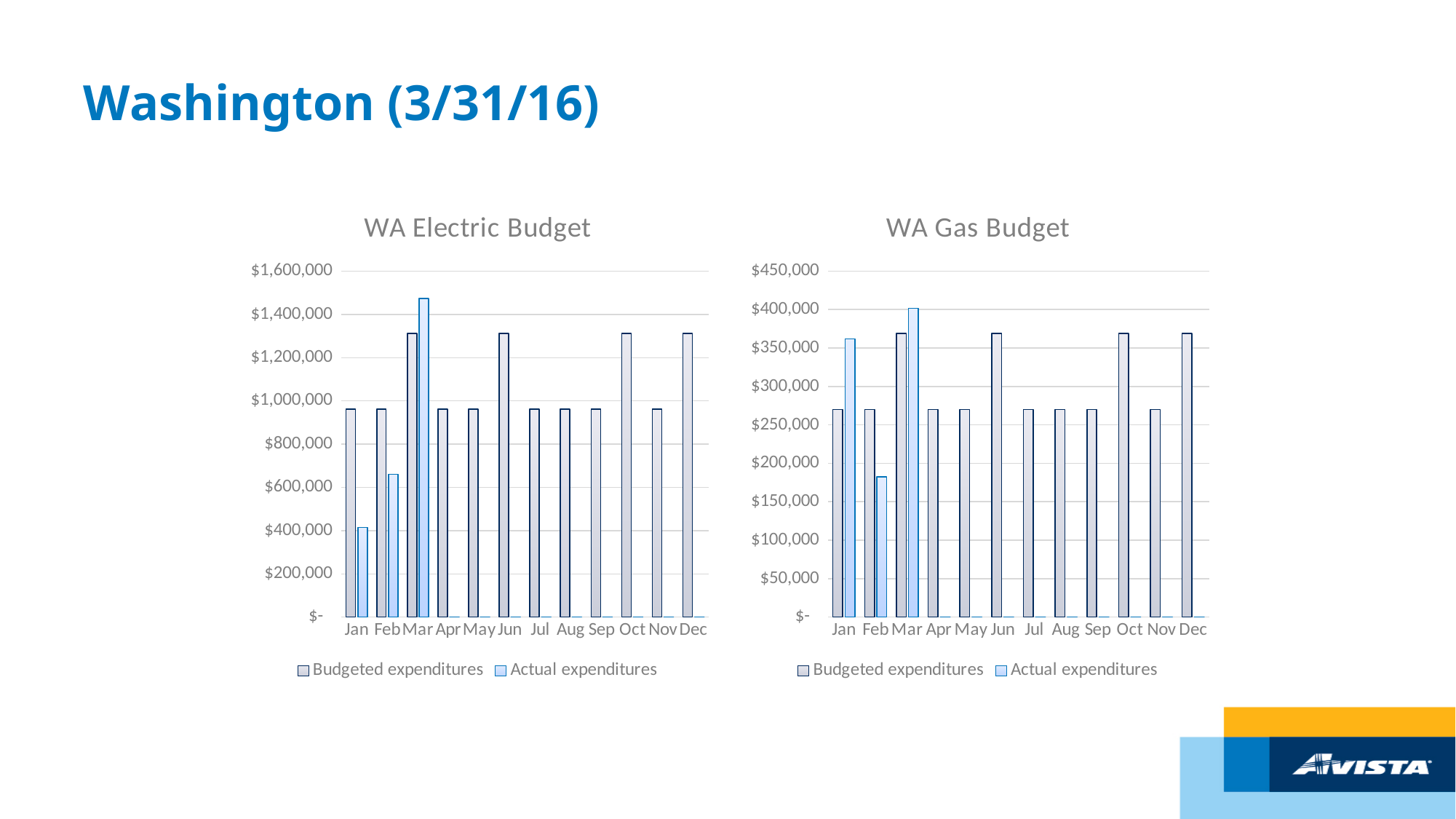
In the WA Electric Budget chart, which month has the highest Actual expenditures? Mar In the WA Electric Budget chart, which is larger: Budgeted expenditures for Mar or for Apr? Mar In the WA Gas Budget chart, is the value for Actual expenditures in Mar greater or less than $350,000? greater In the WA Gas Budget chart, which is larger for Jan: Budgeted expenditures or Actual expenditures? Actual expenditures How many months are shown on the x axis of the WA Electric Budget chart? 12 In the WA Electric Budget chart, is the value for Actual expenditures in Mar greater or less than $1,400,000? greater What kind of chart is the WA Electric Budget chart? bar chart In the WA Gas Budget chart, is the value for Actual expenditures in Feb greater or less than $200,000? less How many series does the legend of the WA Gas Budget chart list? 2 What are the two legend entries in the WA Electric Budget chart? Budgeted expenditures and Actual expenditures